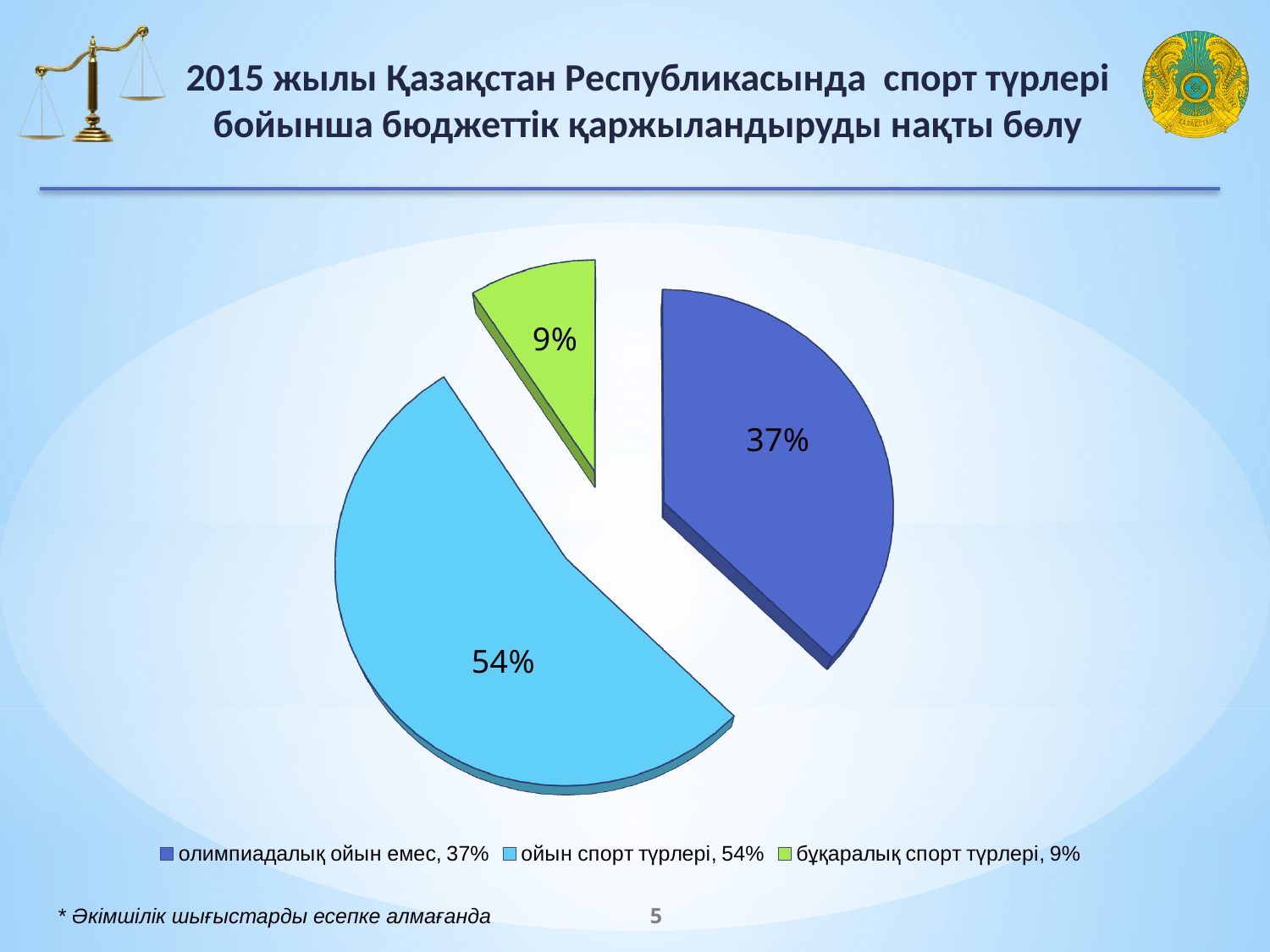
Which category has the smallest slice of the pie? бұқаралық спорт түрлері What kind of chart is shown on the slide? pie chart What share of the pie does "бұқаралық спорт түрлері" have? 9% Which category has the largest slice of the pie? ойын спорт түрлері What colour is the slice for "бұқаралық спорт түрлері"? green What is the difference in percentage points between "олимпиадалық ойын емес" and "бұқаралық спорт түрлері"? 28 What share of the pie does "ойын спорт түрлері" have? 54% What is the difference in percentage points between "ойын спорт түрлері" and "олимпиадалық ойын емес"? 17 How many entries does the legend list? 3 What share of the pie does "олимпиадалық ойын емес" have? 37% How many slices does the pie chart have? 3 Which is larger: the share for "олимпиадалық ойын емес" or the share for "бұқаралық спорт түрлері"? олимпиадалық ойын емес